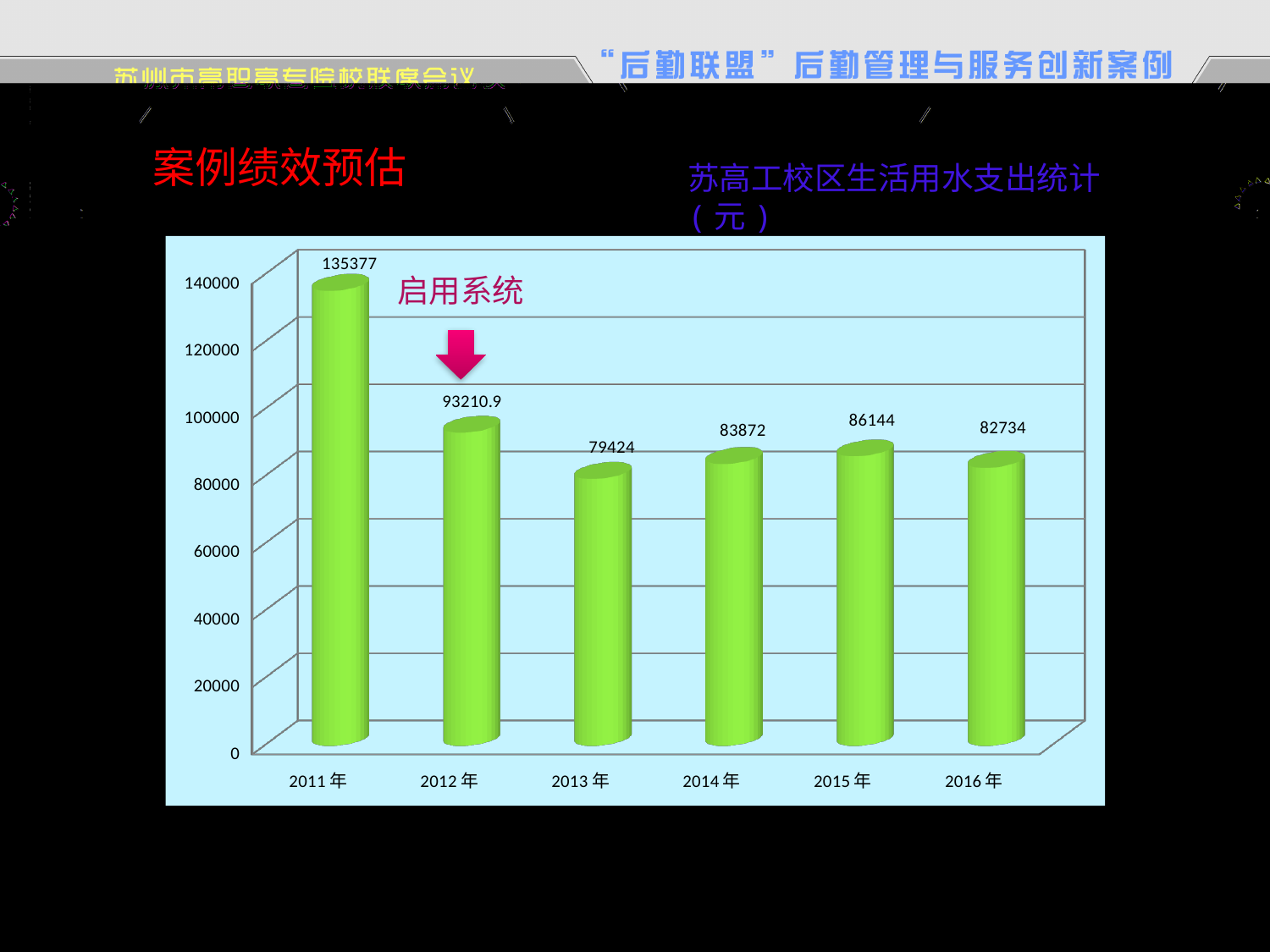
What is the title of the chart? 苏高工校区生活用水支出统计（元） What is the value for 2012年 in the chart? 93210.9 What is the difference between the values for 2015年 and 2013年? 6720 Is the value for 2013年 greater or less than 80000? less What kind of chart is shown on the slide? bar chart What is the difference between the values for 2011年 and 2012年? 42166.1 Which year has the highest value in the chart? 2011年 What is the value for 2011年 in the chart? 135377 Which is larger, the value for 2015年 or the value for 2016年? 2015年 Which year has the lowest value in the chart? 2013年 What is the value for 2015年 in the chart? 86144 How many years are shown on the x axis of the chart? 6